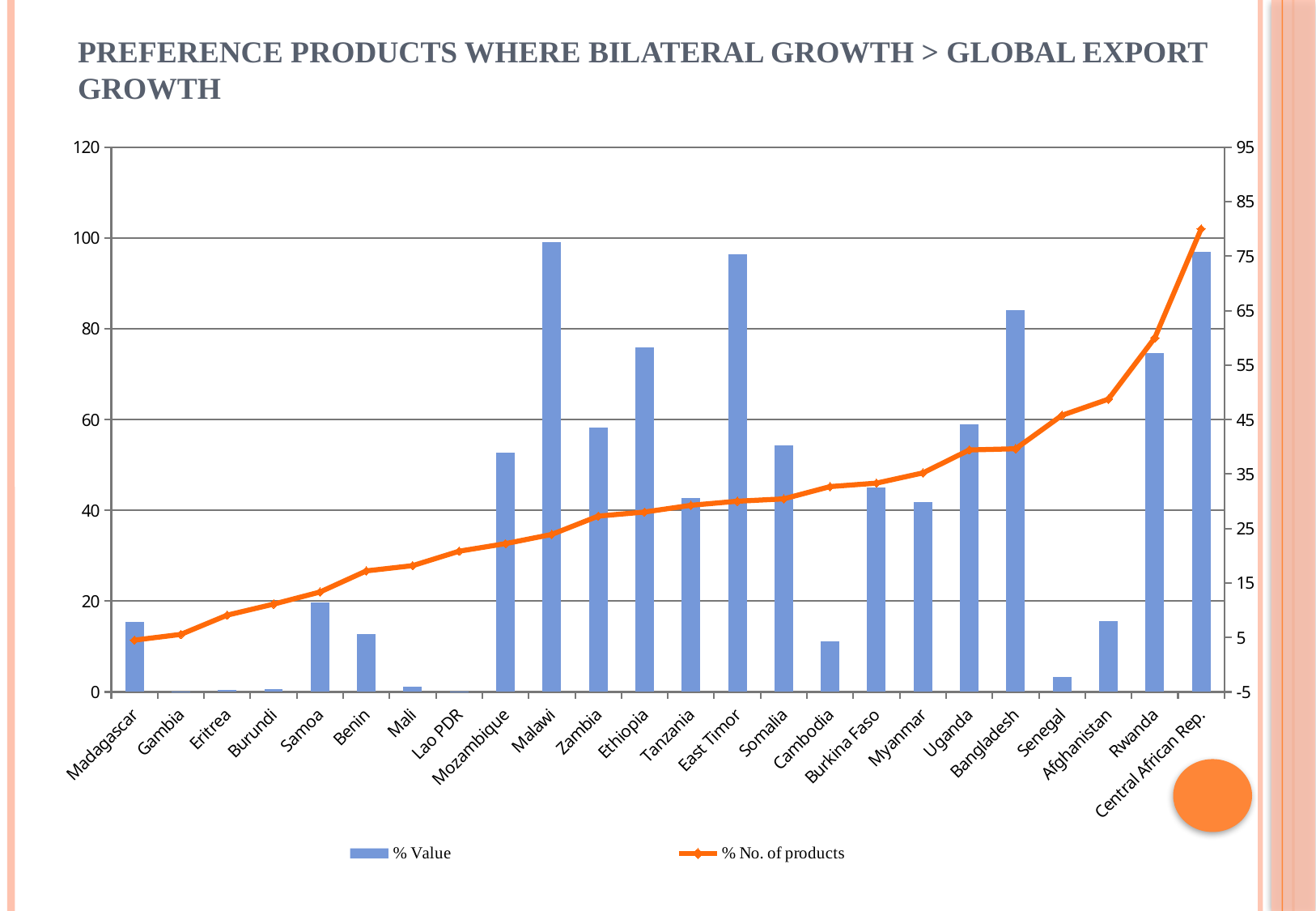
Which country has the highest % No. of products? Central African Rep. Which has the larger % Value, Bangladesh or Uganda? Bangladesh How many series does the legend list? 2 Which has the larger % Value, Malawi or Zambia? Malawi Does the % No. of products line rise or fall from Madagascar to Central African Rep.? Rises How many countries are shown on the x axis? 24 Is the % Value for Malawi greater or less than 80? greater Is the % Value for Ethiopia greater or less than 60? greater Is the % Value for Samoa greater or less than 40? less What kind of chart is shown on the slide? A combined bar and line chart What are the two series named in the legend? % Value and % No. of products